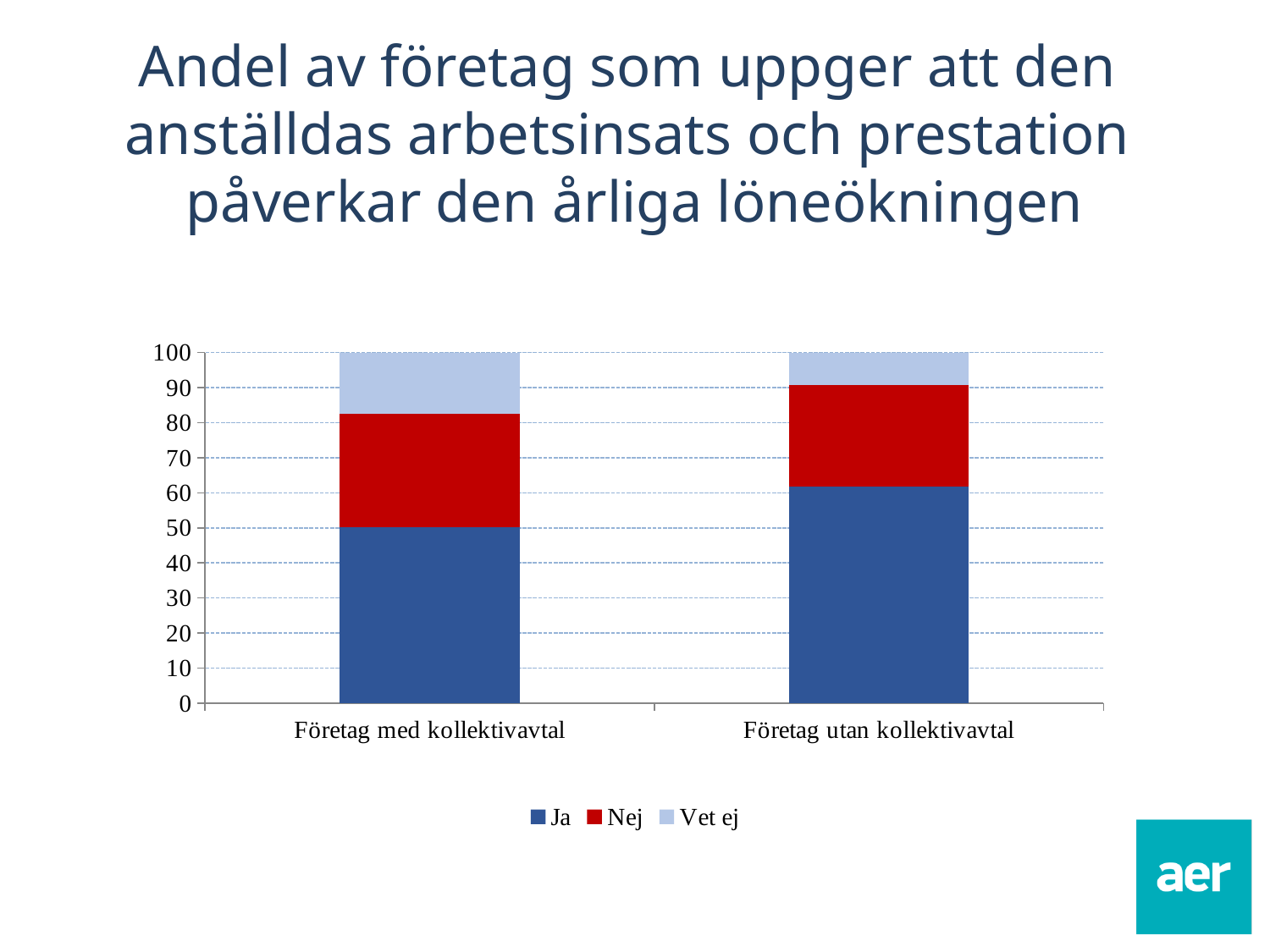
Is the Ja value for Företag med kollektivavtal greater or less than 60? less How many series does the legend list? 3 Is the Vet ej value for Företag med kollektivavtal greater or less than 10? greater What are the entries in the legend? Ja, Nej, Vet ej Is the Nej value for Företag med kollektivavtal greater or less than 40? less What kind of chart is shown on the slide? bar chart Which series forms the bottom segment of each stacked bar? Ja What is the total height of the stacked bar for Företag med kollektivavtal? 100 Which category has the larger Vet ej segment, Företag med kollektivavtal or Företag utan kollektivavtal? Företag med kollektivavtal Which category has the larger Ja value, Företag med kollektivavtal or Företag utan kollektivavtal? Företag utan kollektivavtal How many categories are shown on the x axis? 2